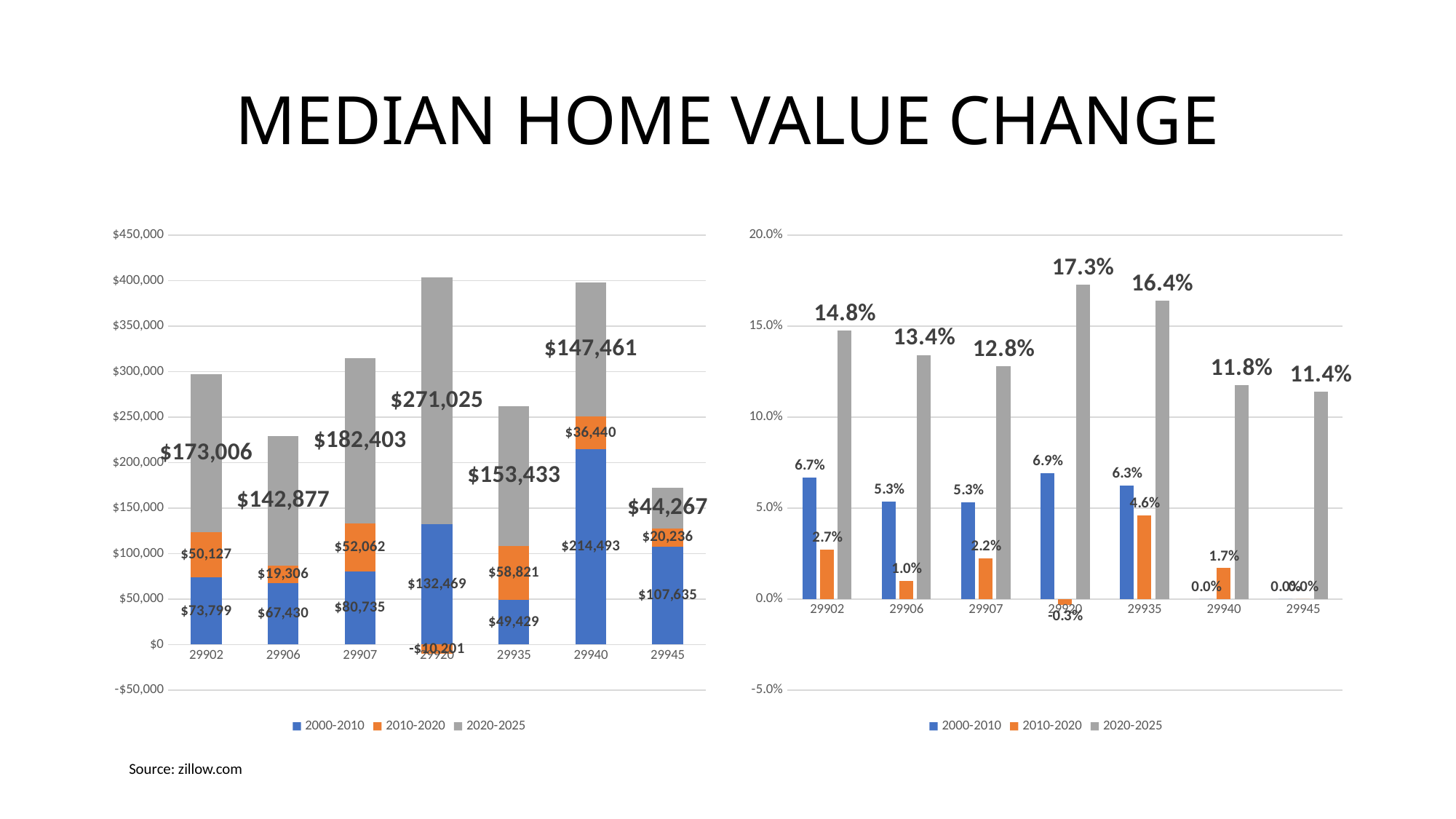
How many series does the legend of the right chart list? 3 On the right chart, which category has the highest 2020-2025 value? 29920 On the right chart, what is the 2010-2020 value for 29920? -0.3% On the left chart, what is the total of the stacked bar for 29902? $296,932 On the left chart, which category has the lowest 2020-2025 value? 29945 On the left chart, what is the 2020-2025 value for 29920? $271,025 On the left chart, which category has the highest 2020-2025 value? 29920 On the left chart, what is the 2000-2010 value for 29940? $214,493 On the left chart, what is the difference between the 2000-2010 values for 29907 and 29906? $13,305 On the right chart, is the 2000-2010 value for 29902 larger or smaller than the 2000-2010 value for 29935? larger On the left chart, what is the 2010-2020 value for 29935? $58,821 On the right chart, what is the 2020-2025 value for 29935? 16.4%